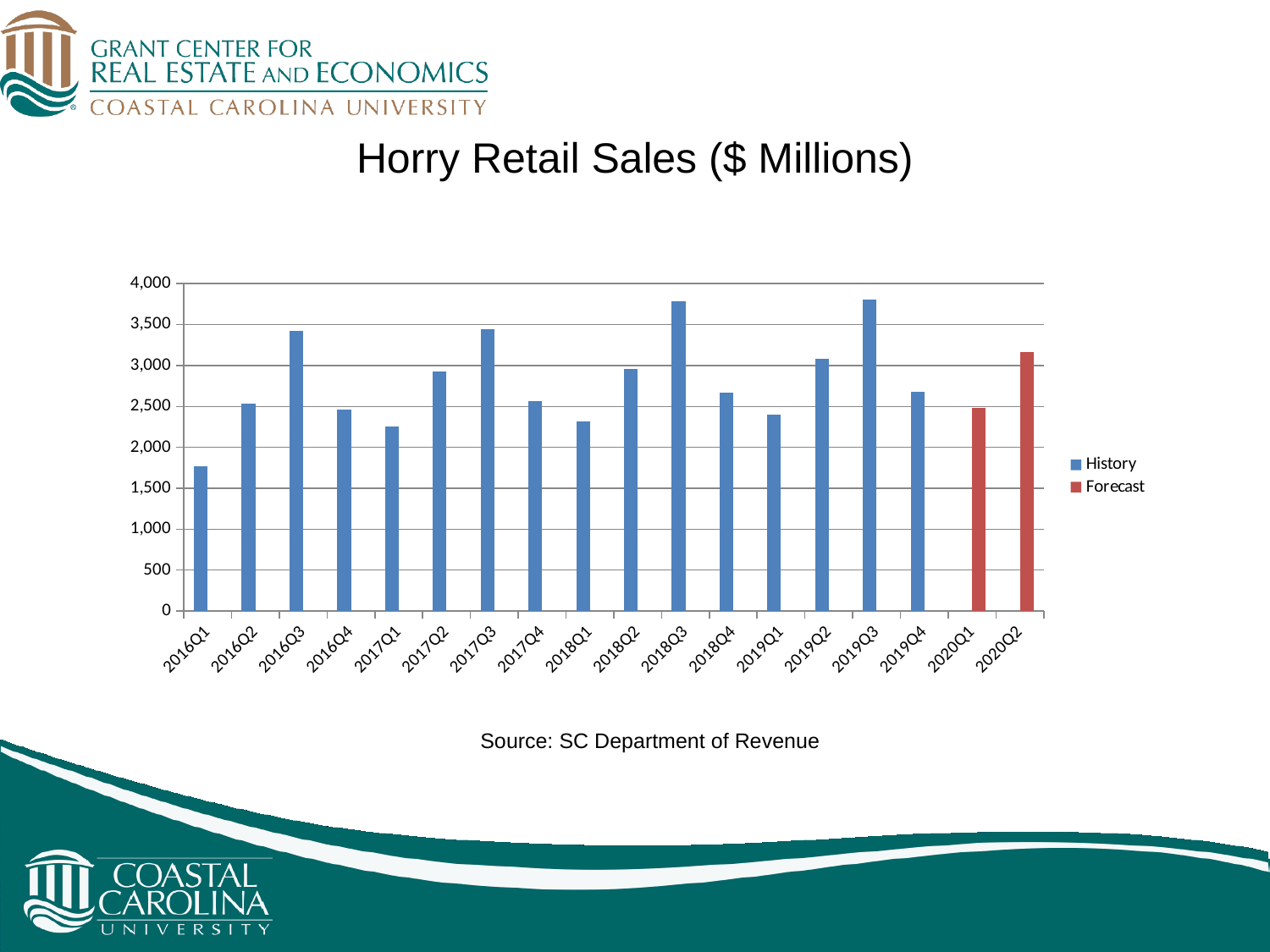
Which is larger, the value for 2016Q3 or the value for 2016Q1? 2016Q3 Which quarter has the lowest retail sales? 2016Q1 What kind of chart is shown on the slide? bar chart How many quarters are plotted on the x axis? 18 What are the two series named in the legend? History and Forecast Is the value for 2020Q2 greater or less than 3,000? greater Which is larger, the value for 2018Q1 or the value for 2018Q2? 2018Q2 Is the value for 2016Q1 greater or less than 2,000? less What is the title of the chart? Horry Retail Sales ($ Millions) Is the value for 2017Q1 greater or less than 2,500? less How many series does the legend list? 2